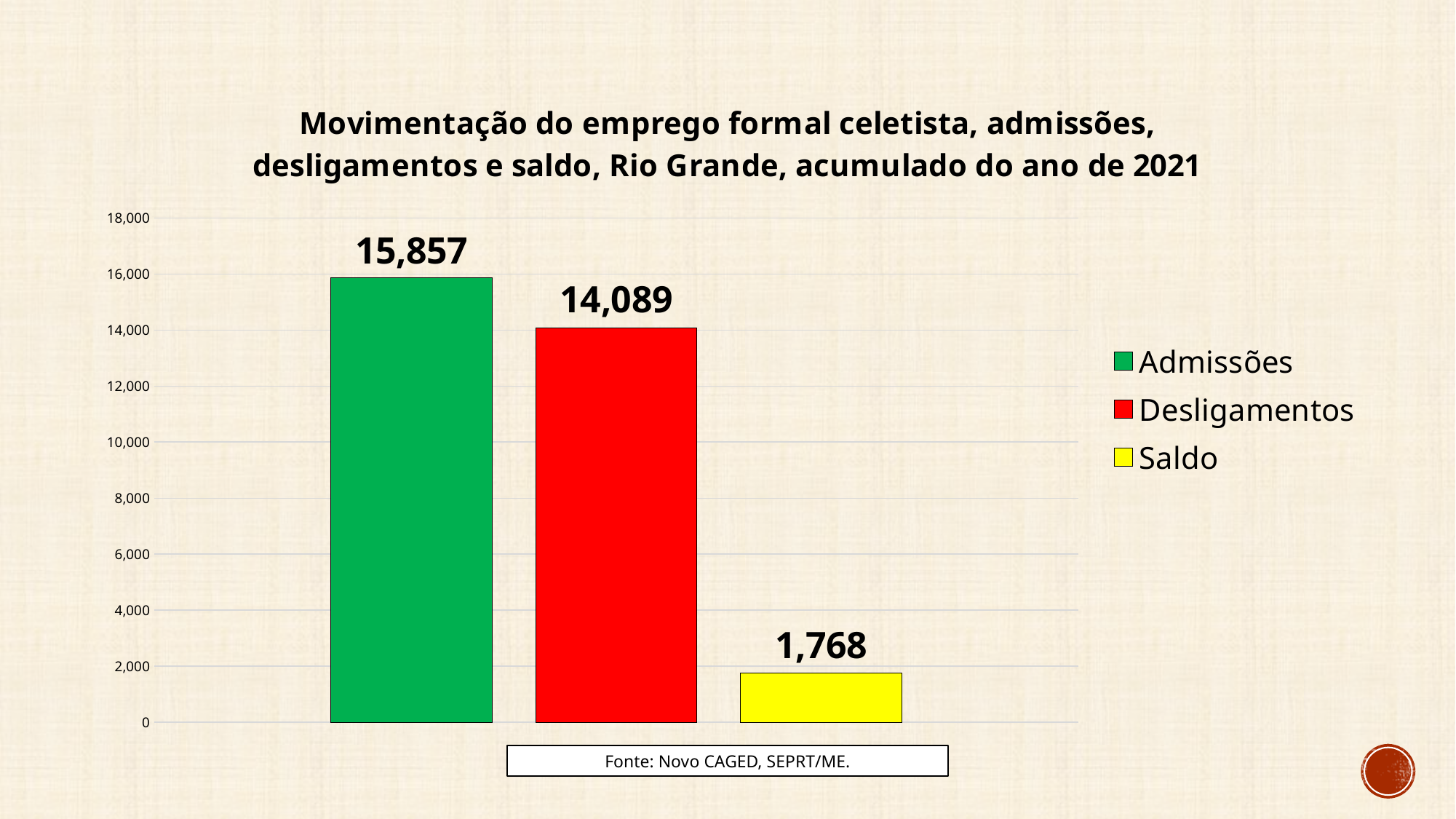
Is the value for Desligamentos greater or less than 14,000? greater What colour is the bar for Saldo? yellow What kind of chart is shown on the slide? bar chart How many series does the legend list? 3 What is the value for Desligamentos? 14,089 Which is larger, Desligamentos or Saldo? Desligamentos What is the value for Admissões? 15,857 Which series has the lowest value? Saldo What is the value for Saldo? 1,768 Which series has the highest value? Admissões How many bars are plotted in the chart? 3 What is the difference between Admissões and Desligamentos? 1,768